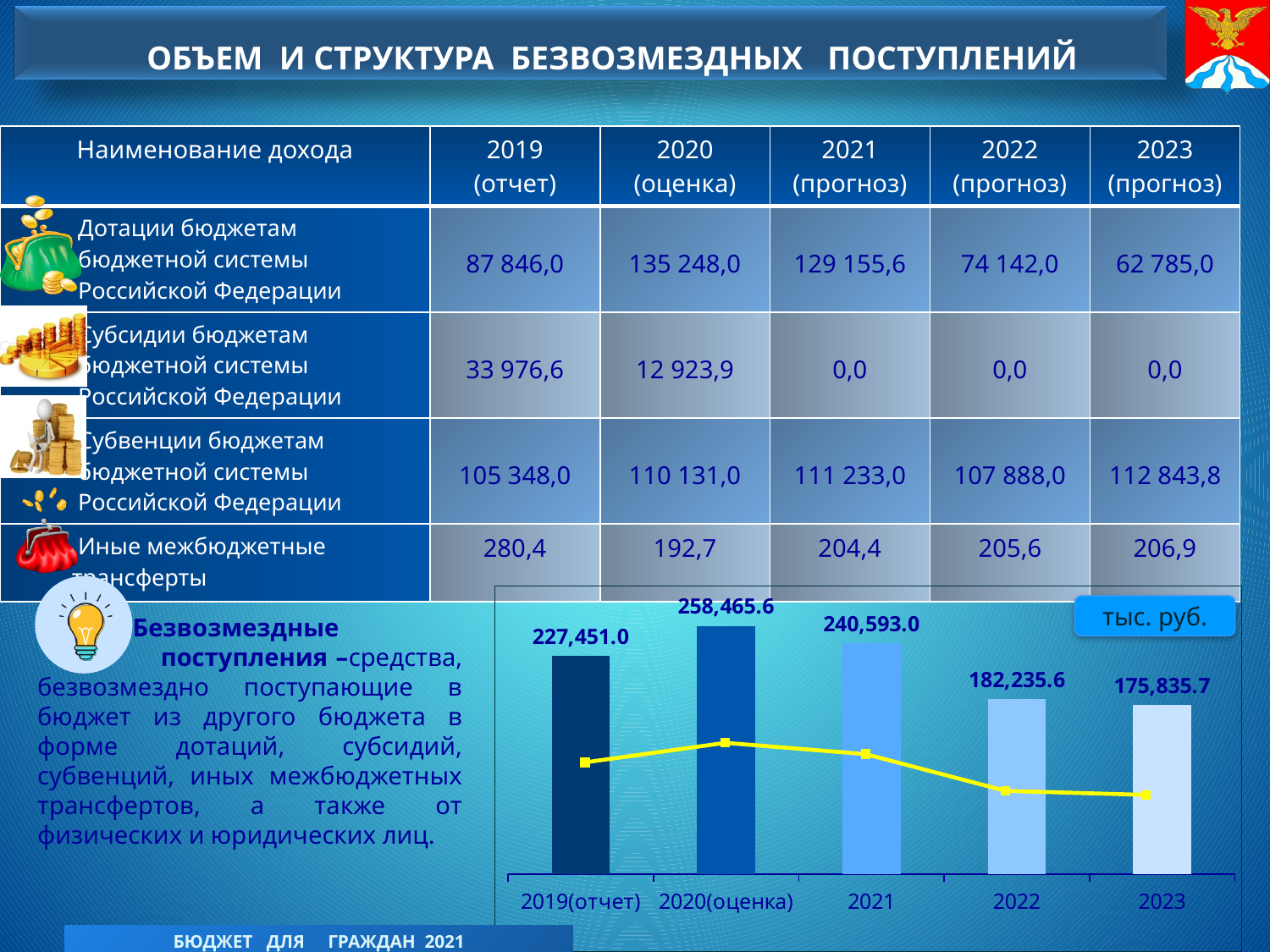
What is the value for 2023 in the chart? 175,835.7 What is the difference between the values for 2020(оценка) and 2019(отчет)? 31,014.6 What is the value for 2020(оценка) in the chart? 258,465.6 What is the difference between the values for 2021 and 2022? 58,357.4 Do the values rise or fall from 2020(оценка) to 2023? fall What is the value for 2022 in the chart? 182,235.6 Which is larger, the value for 2021 or the value for 2022? 2021 Which category has the highest value in the chart? 2020(оценка) What kind of chart is shown on the slide? bar chart How many categories are shown on the x axis of the chart? 5 Which category has the lowest value in the chart? 2023 What is the value for 2019(отчет) in the chart? 227,451.0